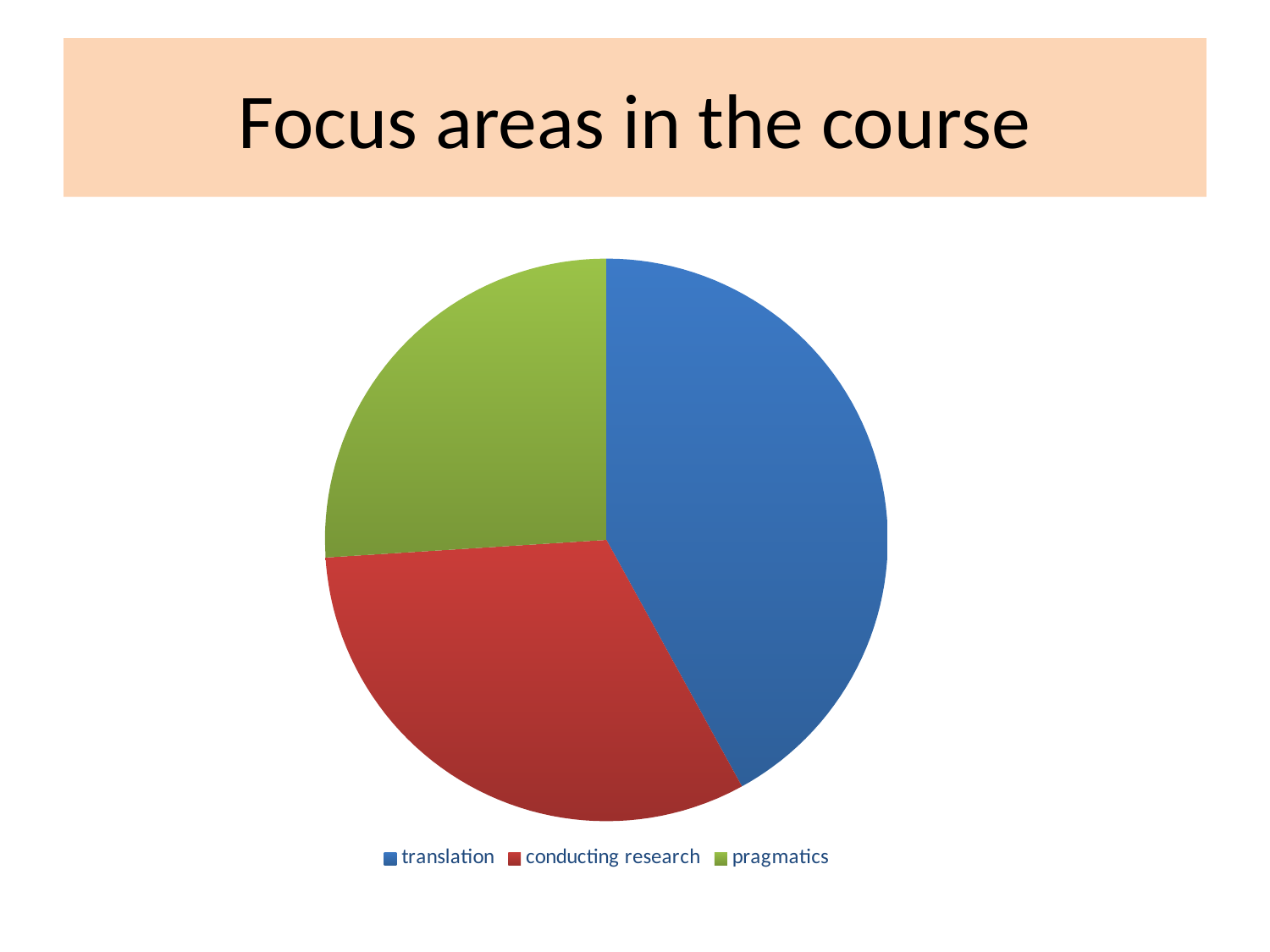
Which legend entry is shown in red? conducting research Which is larger, the slice for translation or the slice for pragmatics? translation What type of chart is shown on the slide? pie chart What is the title of the slide's chart? Focus areas in the course Which is larger, the slice for translation or the slice for conducting research? translation Which focus area has the largest slice of the pie? translation How many entries does the legend list? 3 Which colour represents pragmatics in the pie chart? green How many slices does the pie chart have? 3